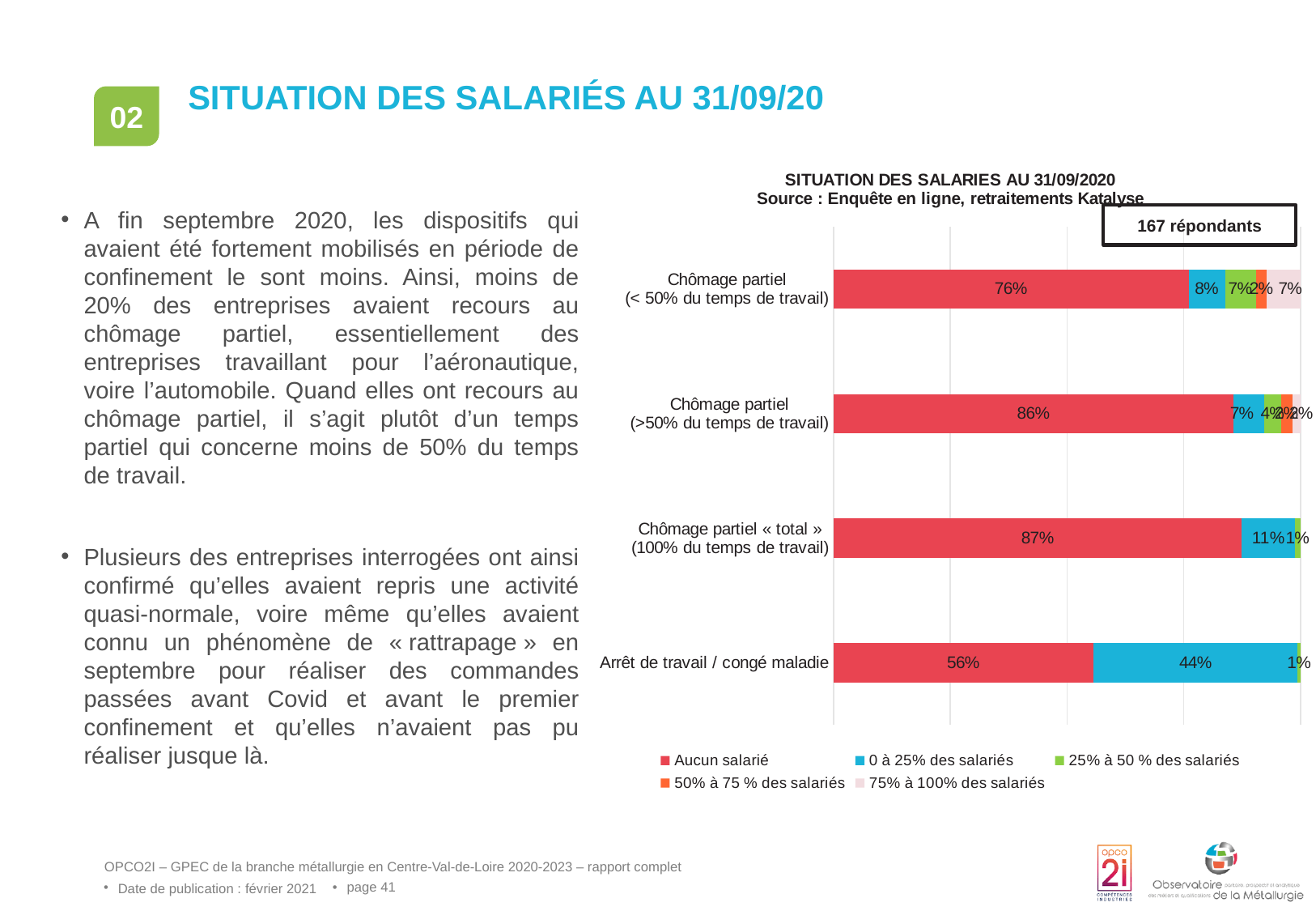
What is the value of "0 à 25% des salariés" for "Arrêt de travail / congé maladie"? 44% What is the value of "0 à 25% des salariés" for "Chômage partiel « total » (100% du temps de travail)"? 11% What kind of chart is shown on the slide? Stacked bar chart What is the value of "Aucun salarié" for "Chômage partiel (>50% du temps de travail)"? 86% What is the value of "Aucun salarié" for "Chômage partiel (< 50% du temps de travail)"? 76% How many categories are plotted on the chart? 4 What is the value of "Aucun salarié" for "Chômage partiel « total » (100% du temps de travail)"? 87% What is the difference between the "Aucun salarié" and "0 à 25% des salariés" values for "Arrêt de travail / congé maladie"? 12% Which category has the lowest value for "Aucun salarié"? Arrêt de travail / congé maladie How many respondents does the chart indicate? 167 répondants Which is larger for "Chômage partiel (< 50% du temps de travail)": "Aucun salarié" or "0 à 25% des salariés"? Aucun salarié How many series does the legend list? 5